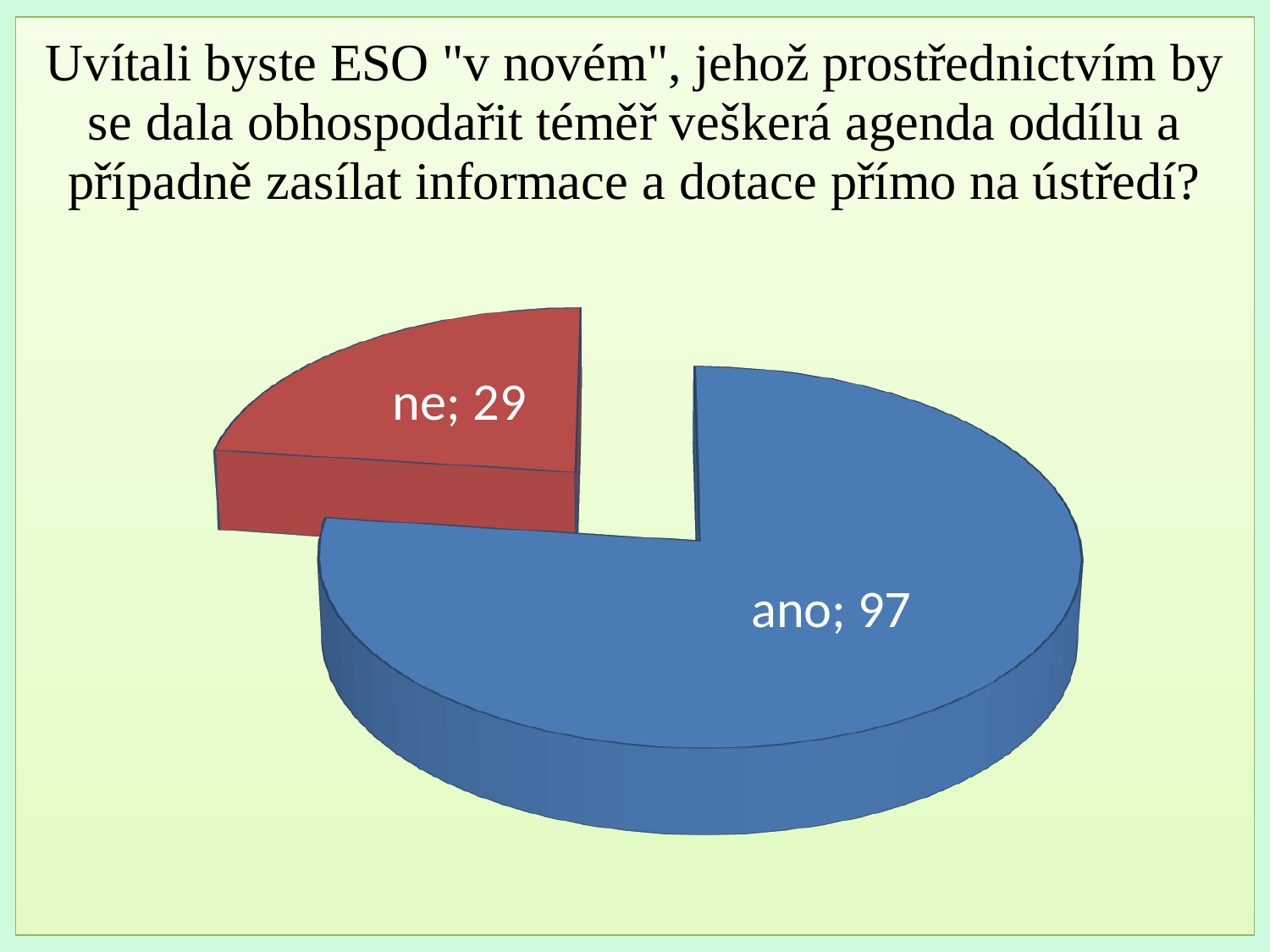
What is the value for "ne" in the pie chart? 29 Which slice of the pie chart is the largest? ano What colour is the "ano" slice in the pie chart? blue What is the difference between the values for "ano" and "ne"? 68 What colour is the "ne" slice in the pie chart? red What share of the pie does the "ano" slice represent, rounded to the nearest whole percent? 77% How many slices does the pie chart have? 2 What kind of chart is shown on the slide? pie chart What is the total of all slices in the pie chart? 126 Which is larger, the value for "ano" or the value for "ne"? ano What is the value for "ano" in the pie chart? 97 Which slice of the pie chart is the smallest? ne